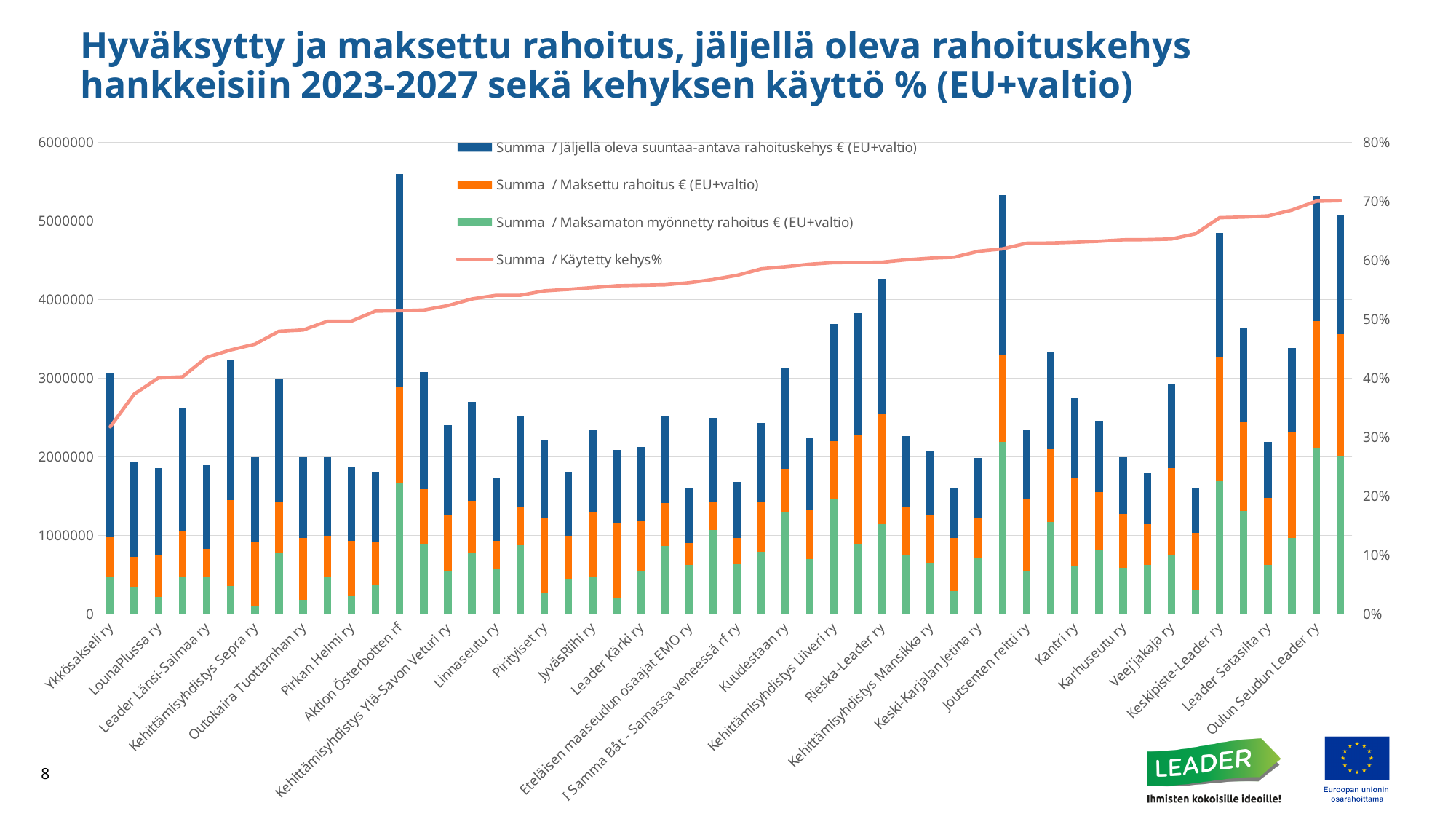
Is the total stacked bar value for Kantri ry greater or less than 2000000? greater Is the total stacked bar value for Linnaseutu ry greater or less than 2000000? less Is the total stacked bar value for Rieska-Leader ry greater or less than 4000000? greater Which category has the tallest stacked bar? Aktion Österbotten rf Which has the larger total stacked bar, Aktion Österbotten rf or Ykkösakseli ry? Aktion Österbotten rf What kind of chart is shown on the slide? Stacked bar chart with a line How many series does the legend list? 4 Does the Käytetty kehys% line rise or fall from left to right along the x axis? Rises Which colour represents 'Summa / Maksettu rahoitus € (EU+valtio)' in the legend? Orange